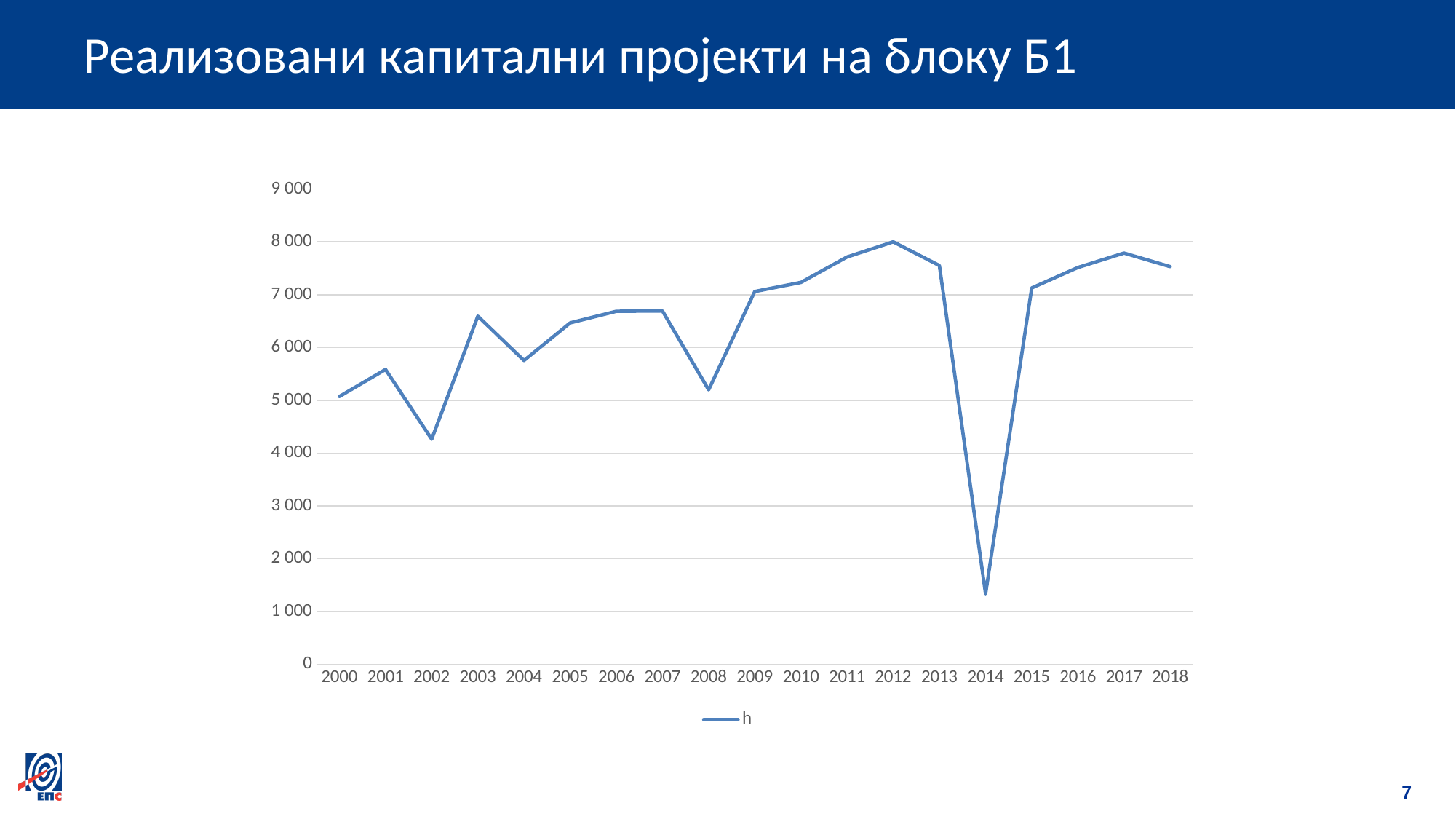
How many years are plotted along the x axis? 19 Is the value for 2011 greater or less than 7 000? greater Is the value for 2002 greater or less than 4 000? greater How many series does the legend list? 1 Does the value rise or fall from 2013 to 2014? fall Is the value for 2001 greater or less than 6 000? less Which year has the lowest value? 2014 What kind of chart is shown on the slide? line chart Which year has the highest value? 2012 Which year has the larger value, 2003 or 2004? 2003 What is the name of the series shown in the legend? h